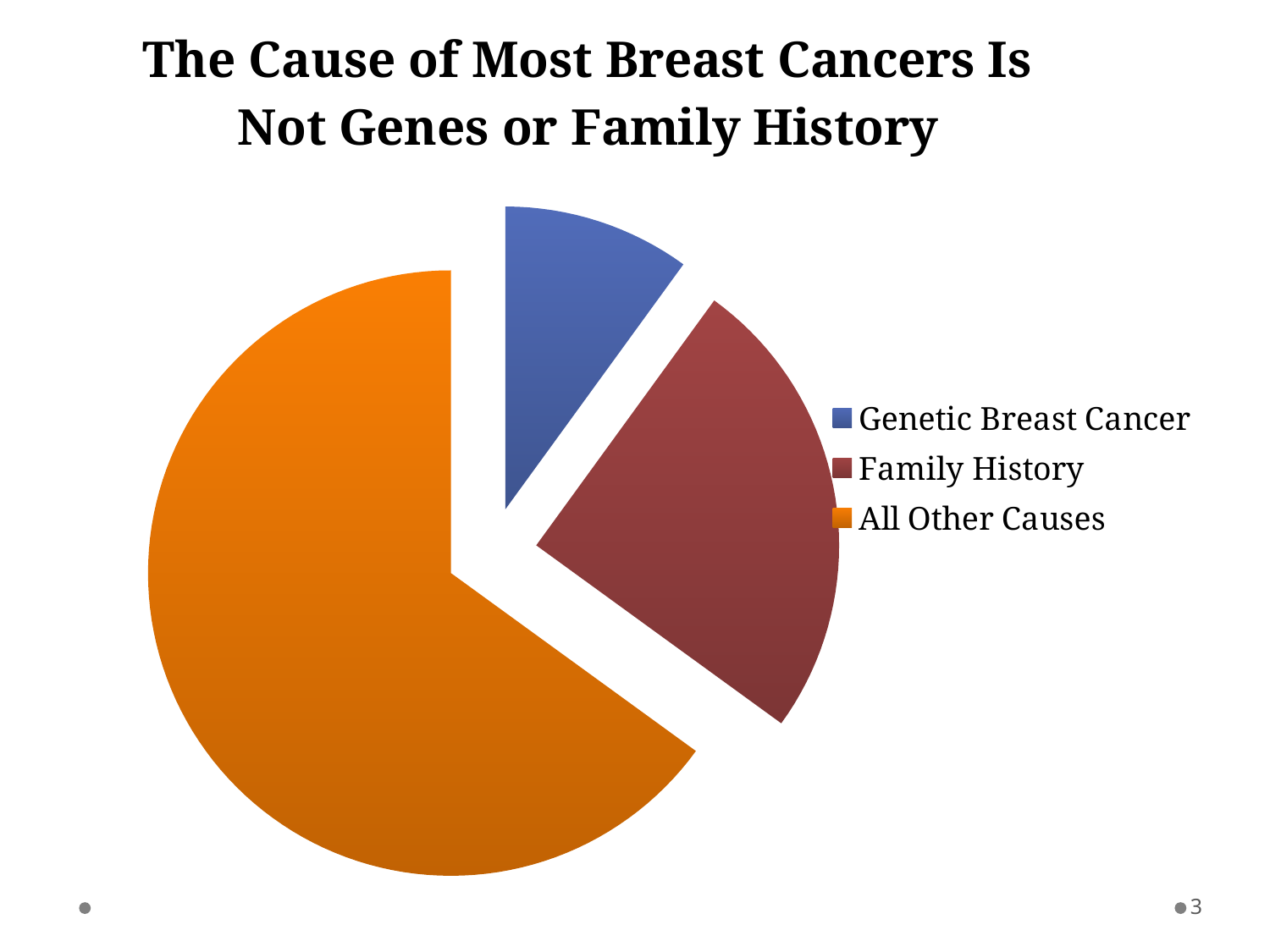
Which category has the largest slice of the pie? All Other Causes Which category has the smallest slice of the pie? Genetic Breast Cancer Which slice is larger, Family History or Genetic Breast Cancer? Family History Which category is shown in blue? Genetic Breast Cancer What kind of chart is shown on the slide? pie chart Which slice is larger, All Other Causes or Family History? All Other Causes How many slices does the pie chart have? 3 What colour is the All Other Causes slice? orange How many entries does the legend list? 3